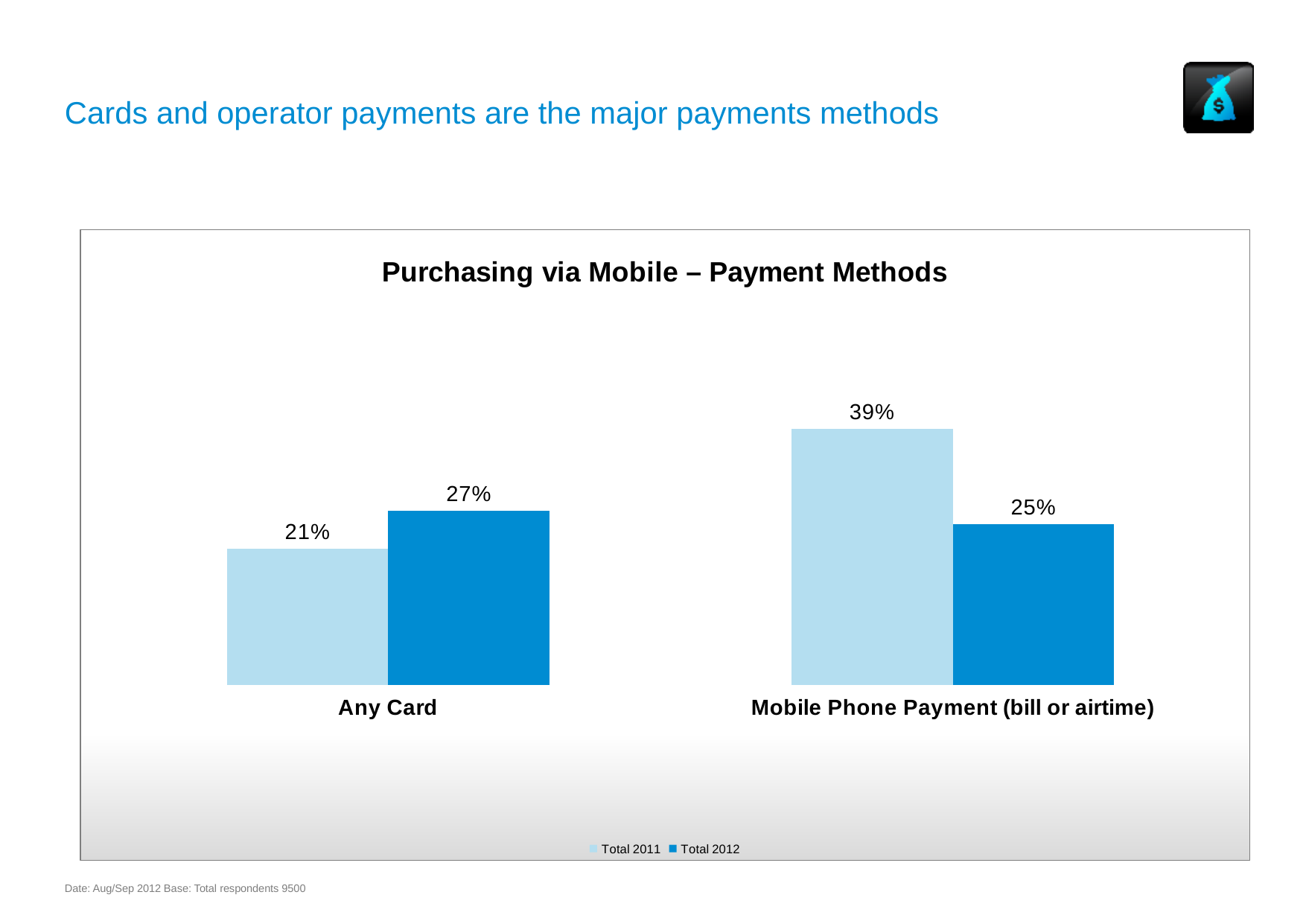
Which category has the lowest Total 2011 value? Any Card What is the difference between the Total 2012 and Total 2011 values for Any Card? 6% What is the Total 2011 value for Mobile Phone Payment (bill or airtime)? 39% What type of chart is shown on the slide? Bar chart Which is larger for Any Card: Total 2011 or Total 2012? Total 2012 What is the Total 2012 value for Mobile Phone Payment (bill or airtime)? 25% How many categories are shown on the x axis? 2 How many series does the legend list? 2 Which category has the highest Total 2011 value? Mobile Phone Payment (bill or airtime) What is the difference between the Total 2011 and Total 2012 values for Mobile Phone Payment (bill or airtime)? 14% What is the Total 2011 value for Any Card? 21% What is the Total 2012 value for Any Card? 27%